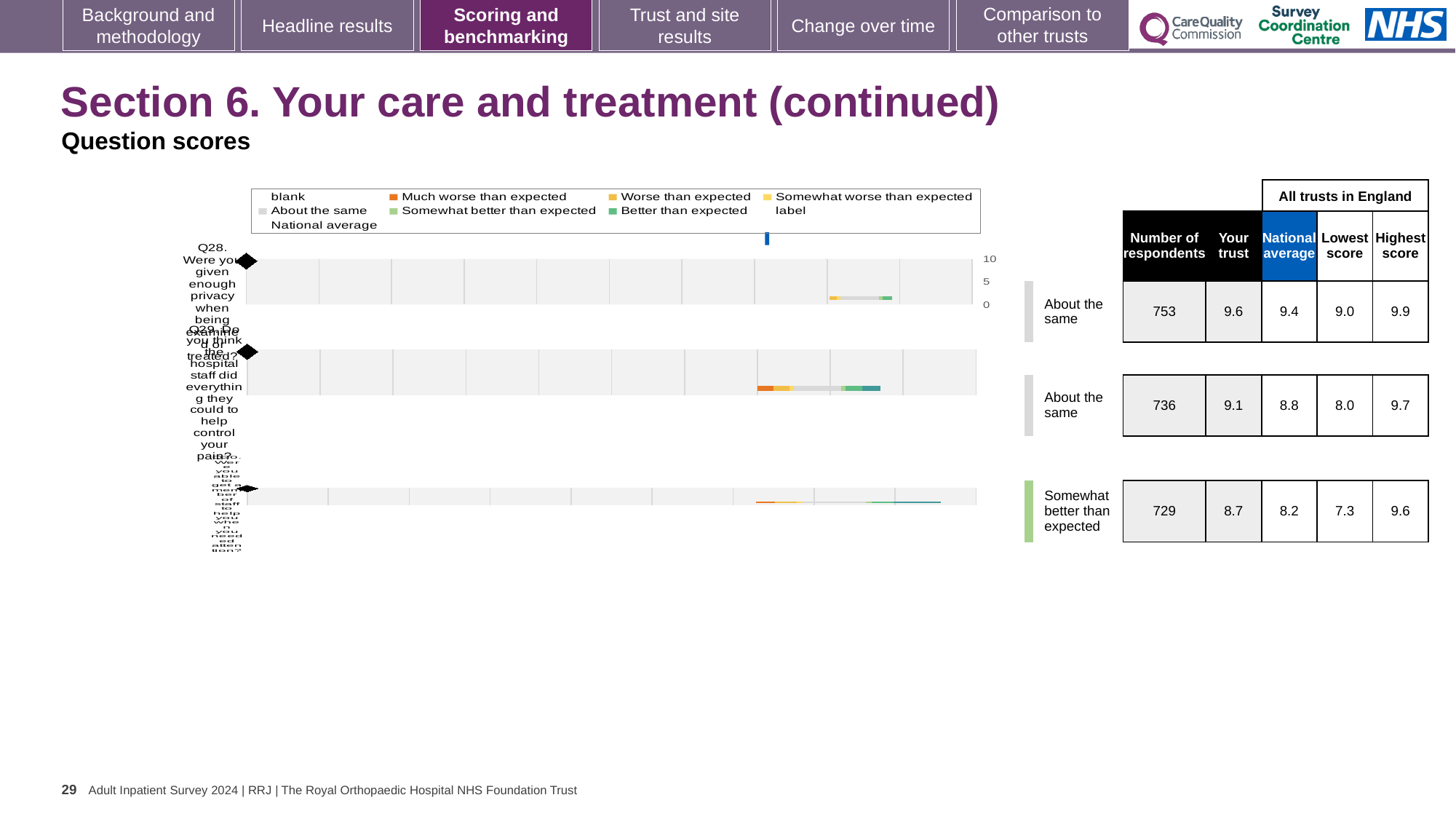
How many respondents answered Q30? 729 For Q29, which is larger: the 'Your trust' score or the national average? Your trust What is the 'Your trust' score for Q28 (privacy when being examined or treated)? 9.6 How many questions (Q28, Q29, Q30) are plotted on the slide? 3 What benchmark category is shown for Q30? Somewhat better than expected What is the difference between the 'Your trust' score and the national average for Q28? 0.2 Which question has the highest 'Your trust' score? Q28 What kind of chart is used to show the question scores on this slide? Bar chart What is the national average score for Q29 (staff did everything to help control your pain)? 8.8 What is the maximum value shown on the score axis of the charts? 10 What is the highest score among all trusts in England for Q30? 9.6 Which question has the lowest 'Your trust' score? Q30